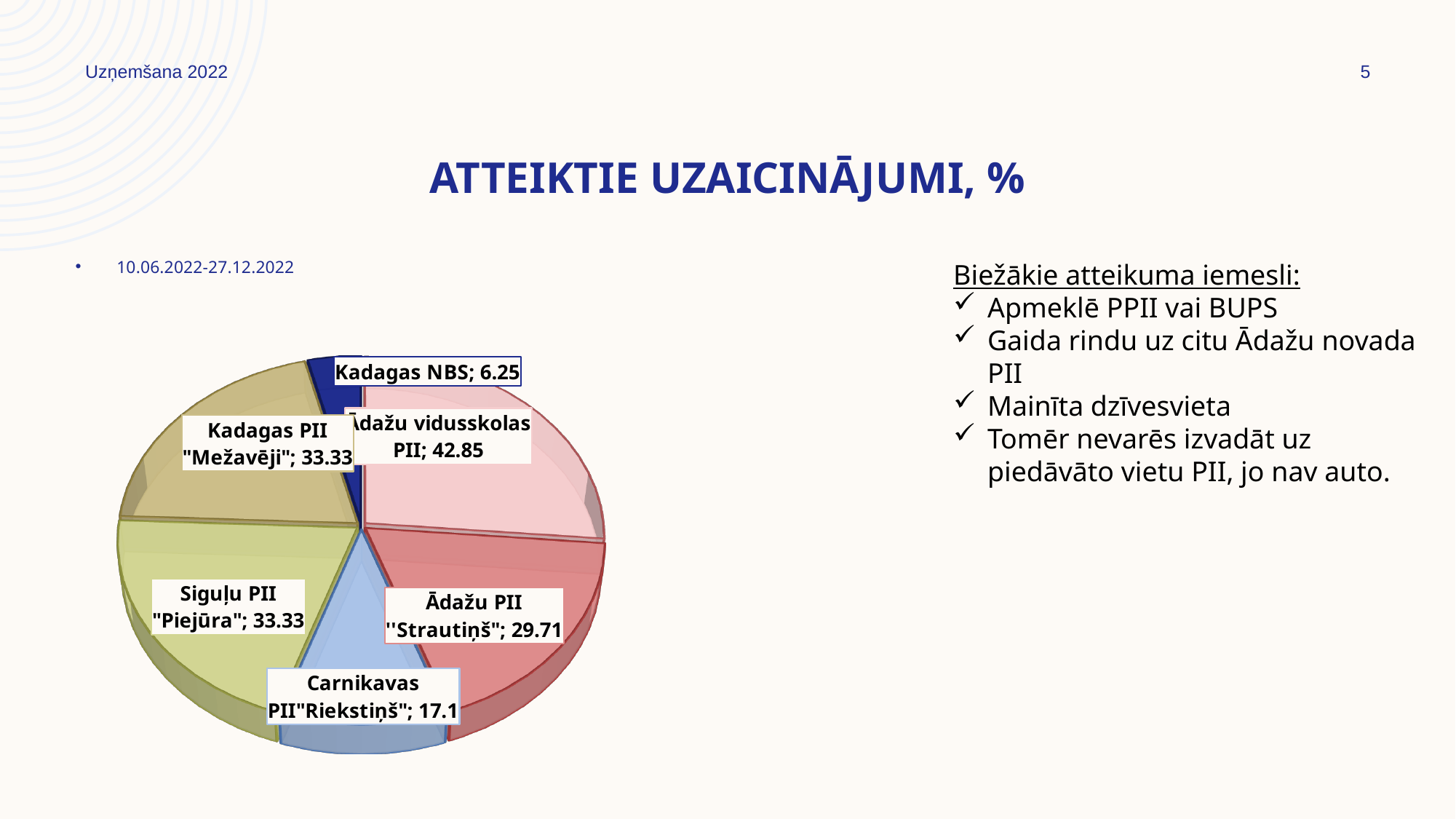
What is the value for Ādažu PII "Strautiņš"? 29.71 What is the value for Carnikavas PII "Riekstiņš"? 17.1 What is the value for Ādažu vidusskolas PII? 42.85 What type of chart is shown on the slide? pie chart What is the title of the chart? ATTEIKTIE UZAICINĀJUMI, % Which category has the highest value? Ādažu vidusskolas PII How many categories are shown in the pie chart? 6 Which is larger, the value for Carnikavas PII "Riekstiņš" or the value for Kadagas PII "Mežavēji"? Kadagas PII "Mežavēji" What is the difference between the values for Ādažu vidusskolas PII and Ādažu PII "Strautiņš"? 13.14 Which category has the lowest value? Kadagas NBS What is the difference between the values for Siguļu PII "Piejūra" and Kadagas NBS? 27.08 What is the value for Kadagas NBS? 6.25